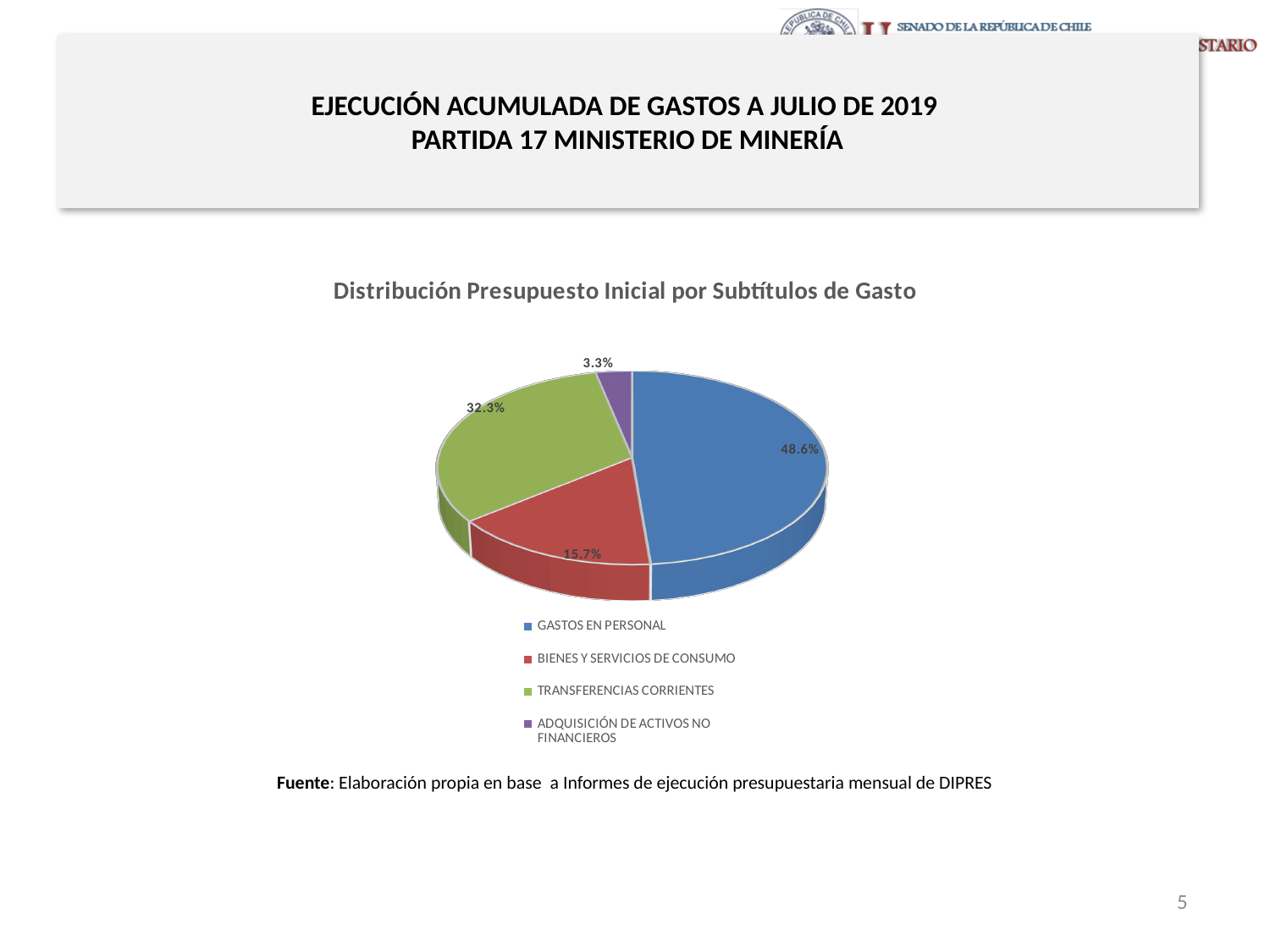
What share of the pie does ADQUISICIÓN DE ACTIVOS NO FINANCIEROS represent? 3.3% What colour is the slice for TRANSFERENCIAS CORRIENTES? Green Which category has the smallest share of the pie? ADQUISICIÓN DE ACTIVOS NO FINANCIEROS What share of the pie does GASTOS EN PERSONAL represent? 48.6% How many categories are shown in the pie chart? 4 What is the difference in percentage points between the share for GASTOS EN PERSONAL and the share for TRANSFERENCIAS CORRIENTES? 16.3 percentage points What is the title of the chart? Distribución Presupuesto Inicial por Subtítulos de Gasto Which is larger, the share for TRANSFERENCIAS CORRIENTES or the share for BIENES Y SERVICIOS DE CONSUMO? TRANSFERENCIAS CORRIENTES What share of the pie does BIENES Y SERVICIOS DE CONSUMO represent? 15.7% Which category has the largest share of the pie? GASTOS EN PERSONAL What kind of chart is shown on the slide? Pie chart